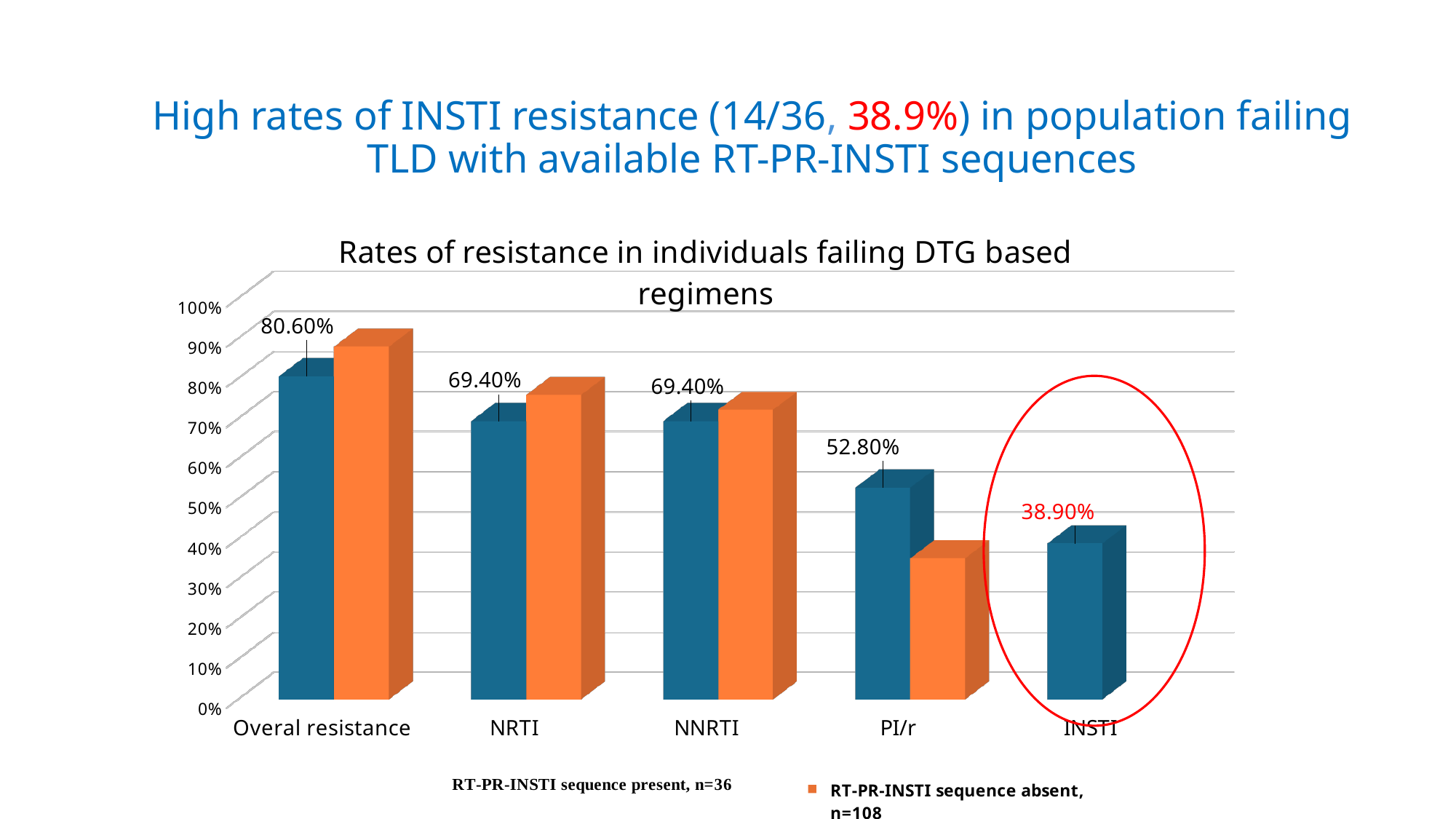
What is the difference between the NRTI and PI/r values in the RT-PR-INSTI sequence present, n=36 series? 16.60% What kind of chart is shown on the slide? bar chart What is the difference between the Overal resistance and INSTI values in the RT-PR-INSTI sequence present, n=36 series? 41.70% Which category has the highest value in the RT-PR-INSTI sequence present, n=36 series? Overal resistance What is the value for PI/r in the RT-PR-INSTI sequence present, n=36 series? 52.80% What is the value for INSTI in the RT-PR-INSTI sequence present, n=36 series? 38.90% What is the value for Overal resistance in the RT-PR-INSTI sequence present, n=36 series? 80.60% In the RT-PR-INSTI sequence present, n=36 series, which is larger: NRTI or PI/r? NRTI Which category has the lowest value in the RT-PR-INSTI sequence present, n=36 series? INSTI Is the value for Overal resistance in the RT-PR-INSTI sequence absent, n=108 series greater or less than 80%? greater How many series does the legend list? 2 How many categories are shown on the x axis? 5